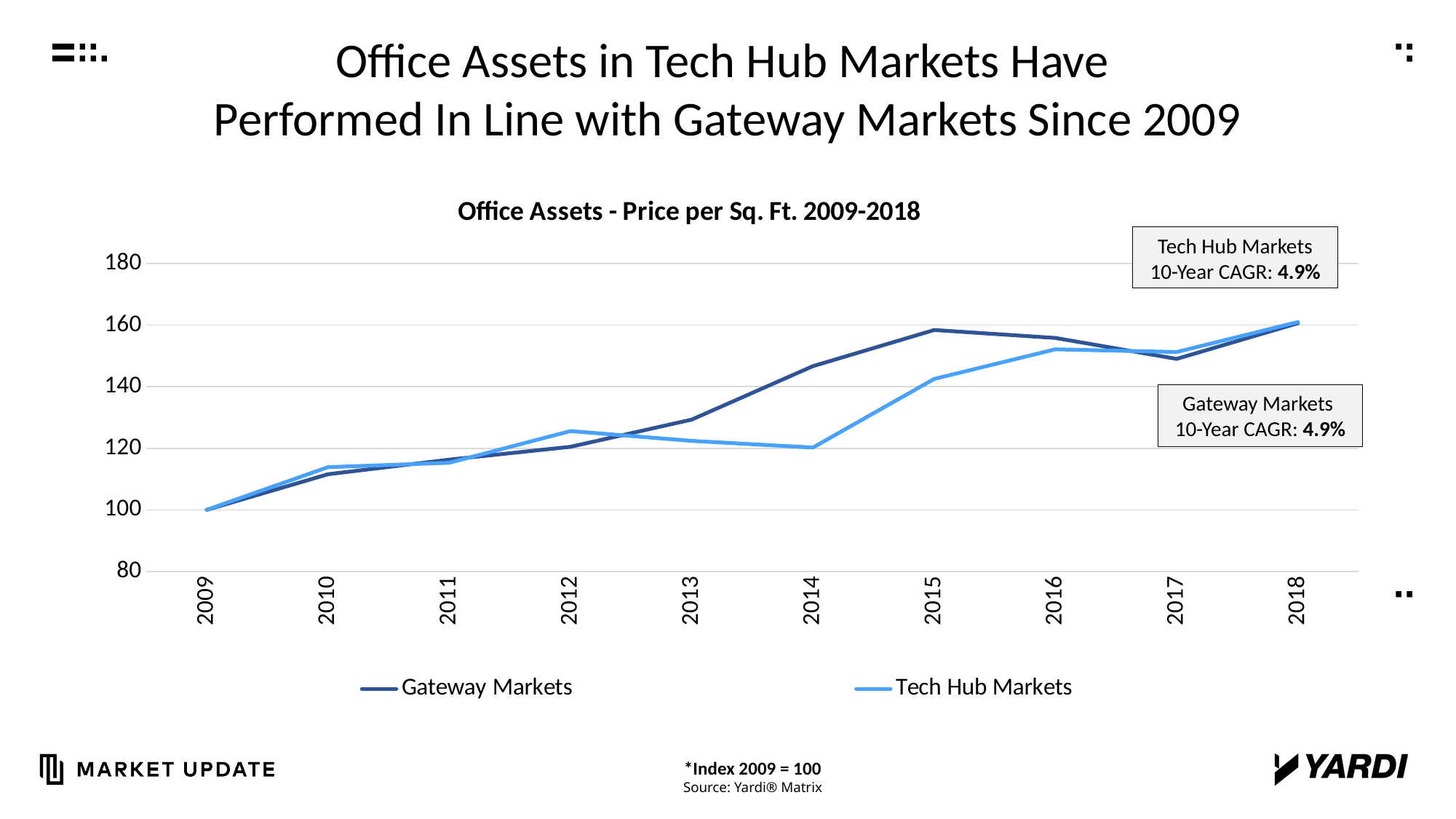
What kind of chart is shown on the slide? line chart What 10-year CAGR is shown for Tech Hub Markets? 4.9% Do the Gateway Markets values rise or fall from 2009 to 2015? rise How many years are plotted along the x axis? 10 What is the index value for Gateway Markets in 2009? 100 In 2014, which series has the higher value, Gateway Markets or Tech Hub Markets? Gateway Markets Is the value for Gateway Markets in 2015 greater or less than 140? greater In 2012, which series has the higher value, Gateway Markets or Tech Hub Markets? Tech Hub Markets How many series does the legend list? 2 In which year is the Tech Hub Markets value highest? 2018 Do the Tech Hub Markets values rise or fall from 2012 to 2014? fall Is the value for Tech Hub Markets in 2014 greater or less than 140? less